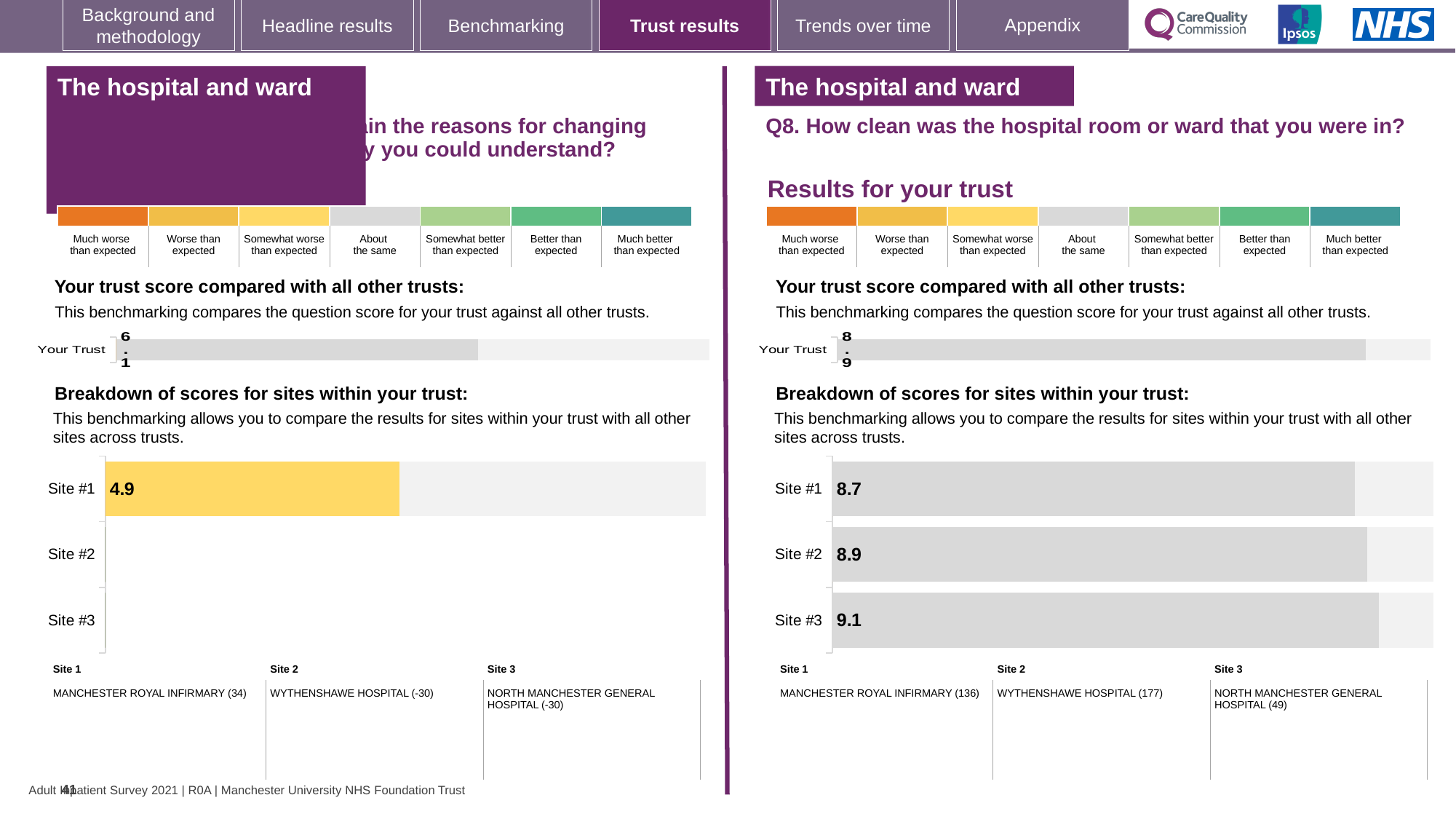
How many sites are listed on the right-hand site breakdown chart (Q8)? 3 On the right-hand chart (Q8), which site has the highest score? Site #3 On the right-hand chart (Q8), what is the score for Site #2? 8.9 What kind of chart is the right-hand site breakdown chart (Q8)? bar chart On the right-hand chart (Q8), what is the difference between the scores for Site #3 and Site #1? 0.4 On the right-hand 'Your trust score compared with all other trusts' chart (Q8), what is the score shown for Your Trust? 8.9 On the right-hand chart (Q8), is the score for Site #2 larger or smaller than the score for Site #1? larger On the left-hand site breakdown chart, what is the score for Site #1? 4.9 On the right-hand chart (Q8), which site has the lowest score? Site #1 On the right-hand chart (Q8, how clean was the hospital room or ward), what is the score for Site #3? 9.1 On the left-hand 'Your trust score compared with all other trusts' chart, what is the score shown for Your Trust? 6.1 On the right-hand chart (Q8), what is the score for Site #1? 8.7